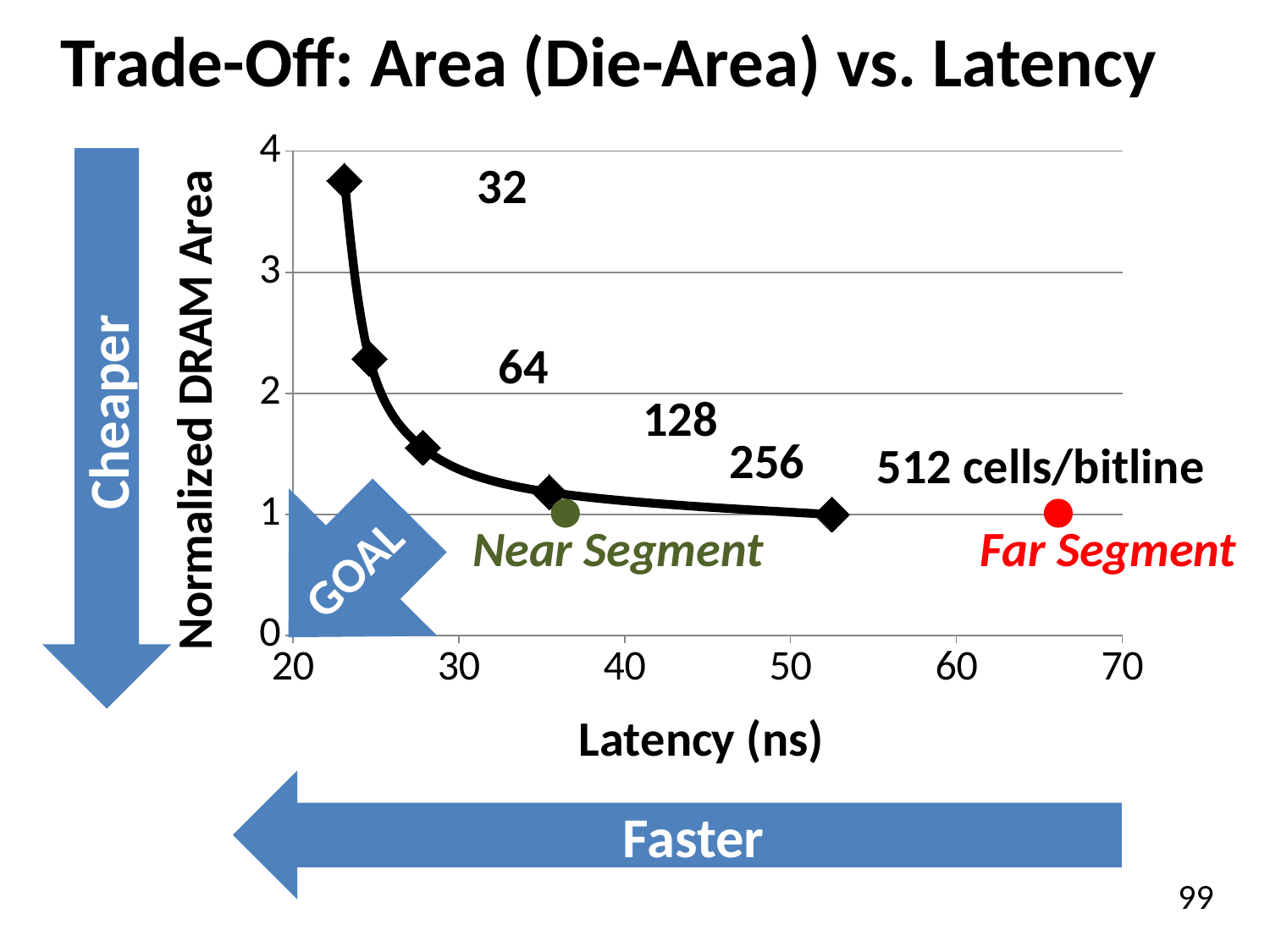
Which has the lower latency, the Near Segment or the Far Segment? Near Segment Is the normalized DRAM area for 128 cells/bitline greater or less than 2? less Which cells/bitline configuration has the lowest normalized DRAM area? 512 As latency increases along the x axis, does the normalized DRAM area rise or fall? fall What is the label of the x axis? Latency (ns) Is the normalized DRAM area for 64 cells/bitline greater or less than 2? greater What kind of chart is shown on the slide? line chart Which cells/bitline configuration has the highest normalized DRAM area? 32 How many black diamond data points are plotted on the curve? 5 Is the latency for 512 cells/bitline greater or less than 50 ns? greater Which has the higher normalized DRAM area, 64 cells/bitline or 256 cells/bitline? 64 cells/bitline